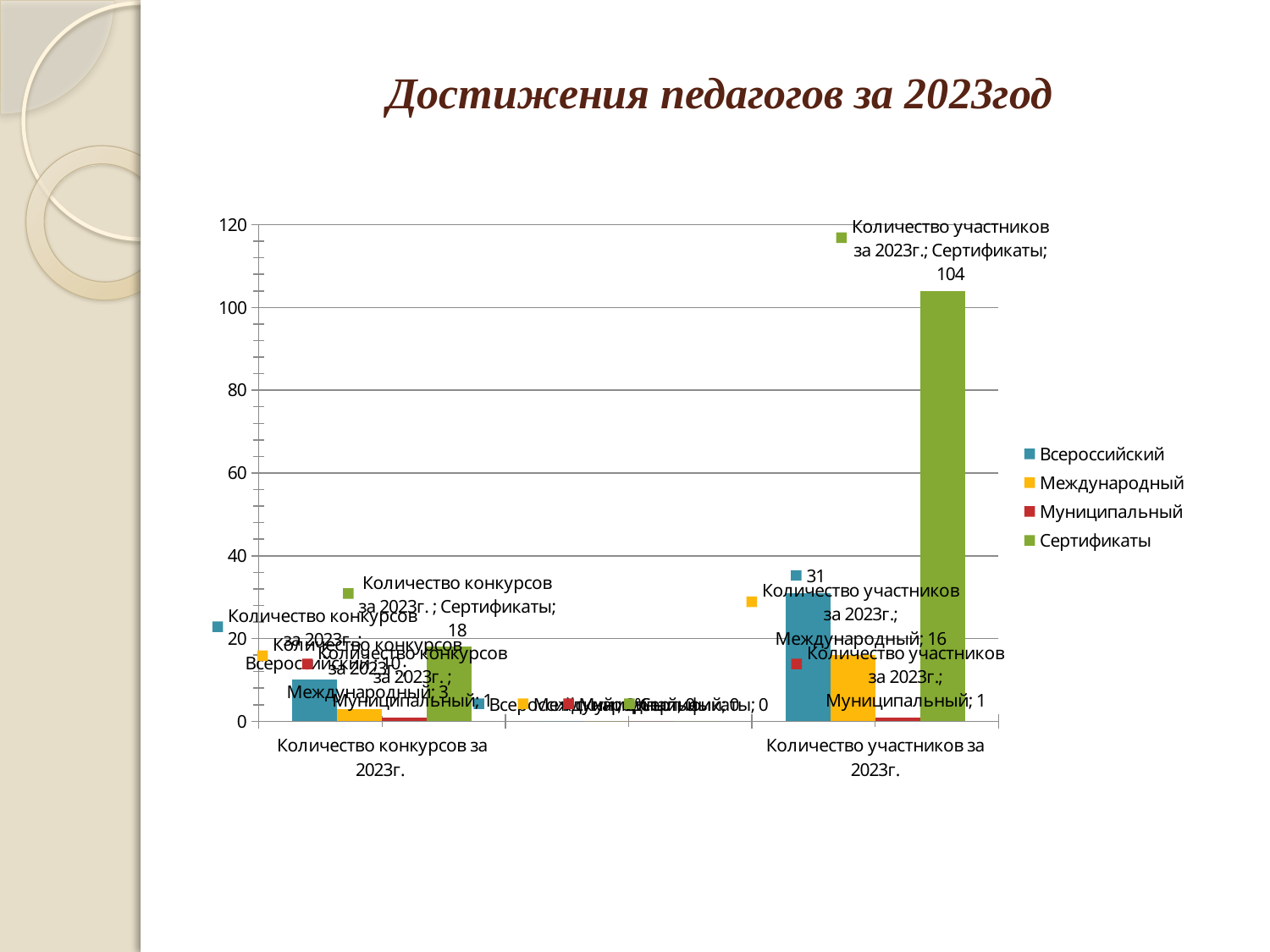
How many series does the legend list? 4 Is the value of Сертификаты for Количество участников за 2023г. greater or less than 100? greater Which is larger for Количество участников за 2023г.: Всероссийский or Международный? Всероссийский What is the value of Сертификаты for Количество конкурсов за 2023г.? 18 What is the value of Всероссийский for Количество участников за 2023г.? 31 What is the value of Муниципальный for Количество участников за 2023г.? 1 What is the value of Сертификаты for Количество участников за 2023г.? 104 Which series has the highest bar in the Количество участников за 2023г. category? Сертификаты What is the title of the slide's chart? Достижения педагогов за 2023год What is the difference between Сертификаты and Всероссийский for Количество участников за 2023г.? 73 What is the value of Международный for Количество участников за 2023г.? 16 What kind of chart is shown on the slide? bar chart